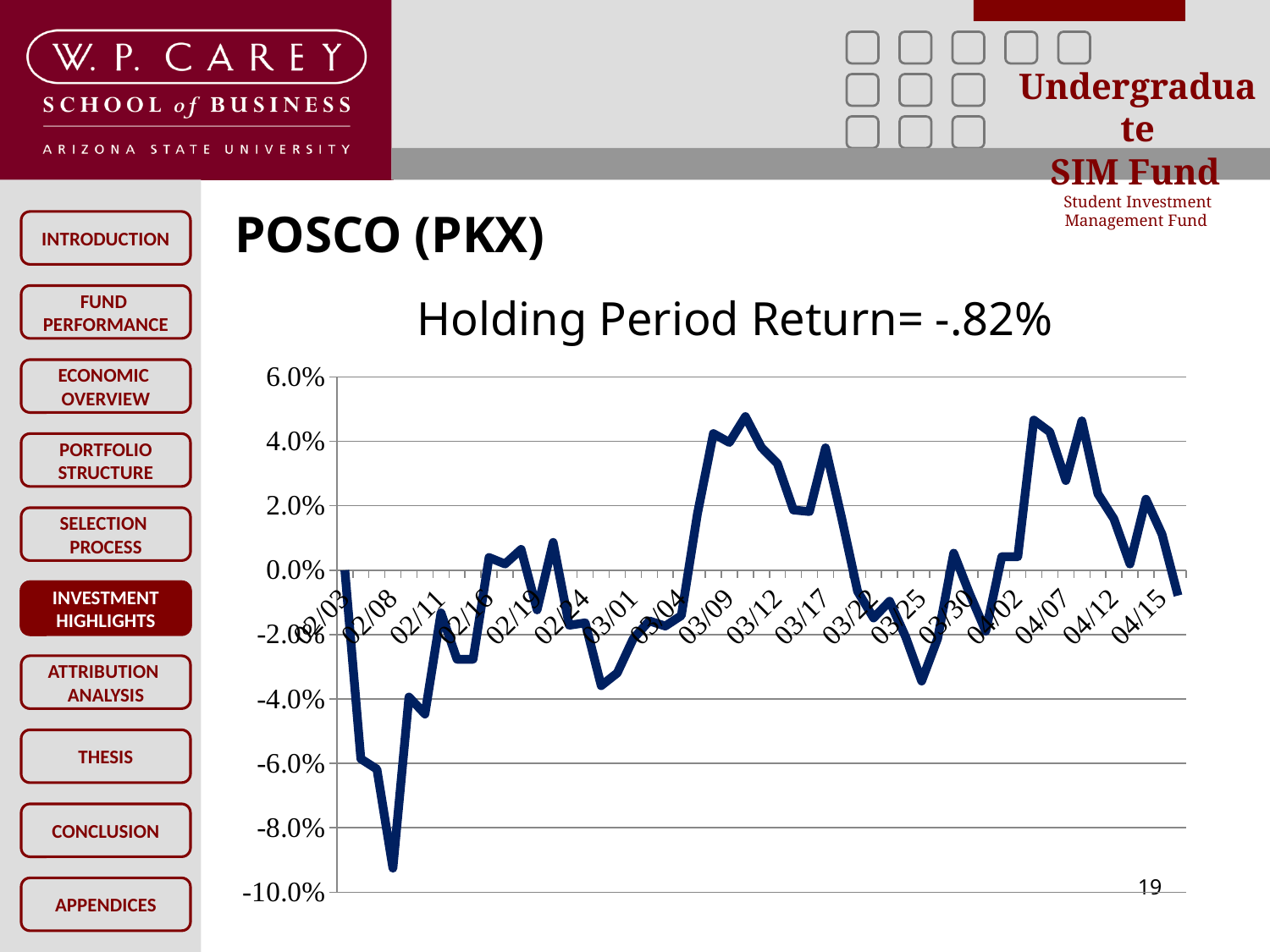
What is the title of the chart? Holding Period Return= -.82% What holding period return is stated in the chart title? -.82% Is the value at 02/08 greater or less than -6.0%? less Is the highest value on the chart greater or less than 4.0%? greater Is the lowest value on the chart greater or less than -8.0%? less What kind of chart is shown on the slide? line chart What is the highest value shown on the y axis? 6.0% Near which x-axis date does the line reach its lowest point? 02/08 Does the line rise or fall between 02/03 and 02/08? fall How many lines (series) are plotted on the chart? 1